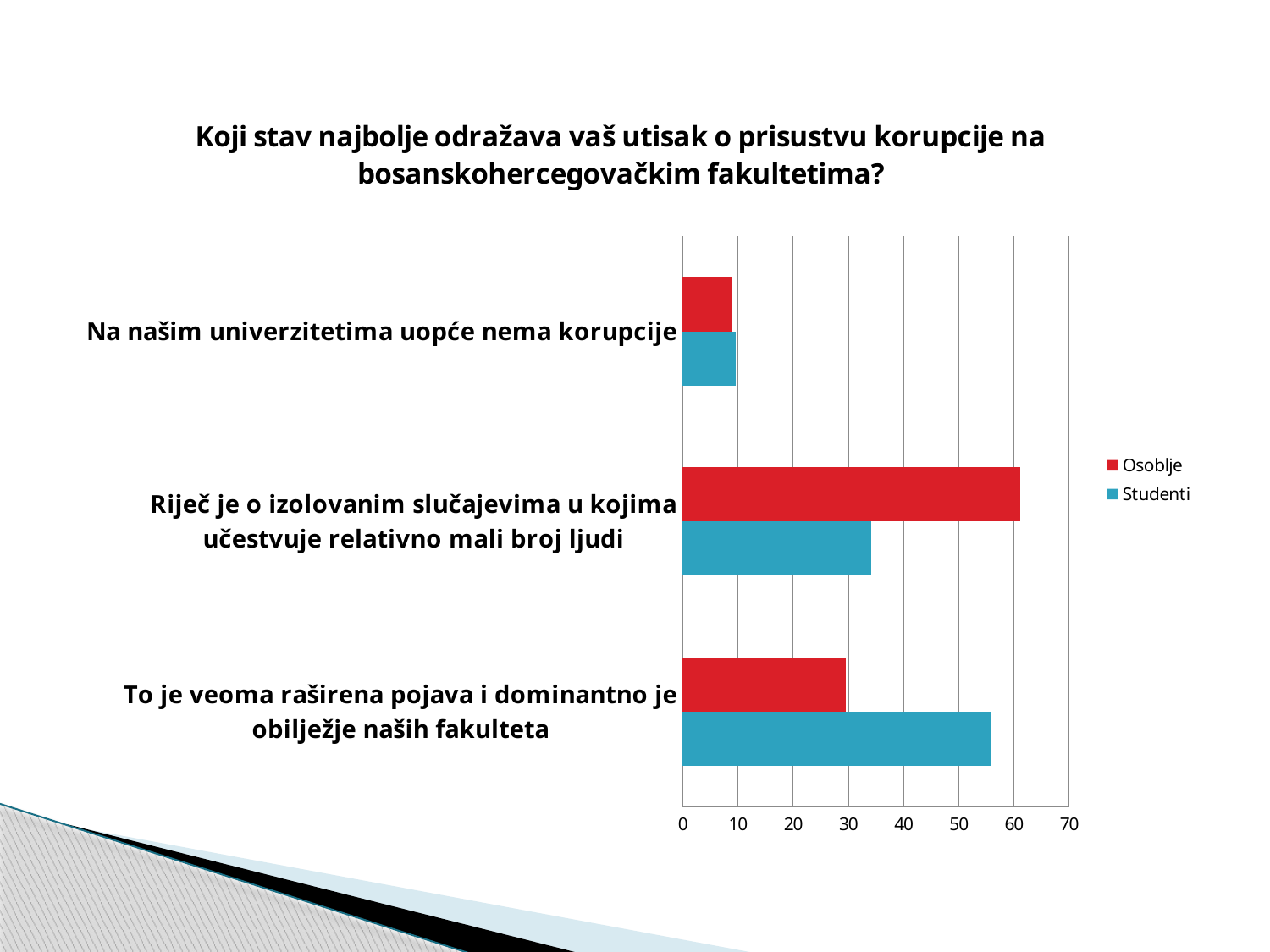
Is the Studenti value for 'Riječ je o izolovanim slučajevima u kojima učestvuje relativno mali broj ljudi' greater or less than 40? less What kind of chart is shown on the slide? bar chart Is the Osoblje value for 'Riječ je o izolovanim slučajevima u kojima učestvuje relativno mali broj ljudi' greater or less than 50? greater Is the Osoblje value for 'Na našim univerzitetima uopće nema korupcije' greater or less than 20? less Which series is shown in red in the legend? Osoblje How many categories (statements) are shown on the chart? 3 For the statement 'Riječ je o izolovanim slučajevima u kojima učestvuje relativno mali broj ljudi', which series has the larger value, Osoblje or Studenti? Osoblje For which statement is the Osoblje value highest? Riječ je o izolovanim slučajevima u kojima učestvuje relativno mali broj ljudi For which statement is the Studenti value highest? To je veoma raširena pojava i dominantno je obilježje naših fakulteta For the statement 'To je veoma raširena pojava i dominantno je obilježje naših fakulteta', which series has the larger value, Osoblje or Studenti? Studenti For which statement is the Studenti value lowest? Na našim univerzitetima uopće nema korupcije How many series does the legend list? 2